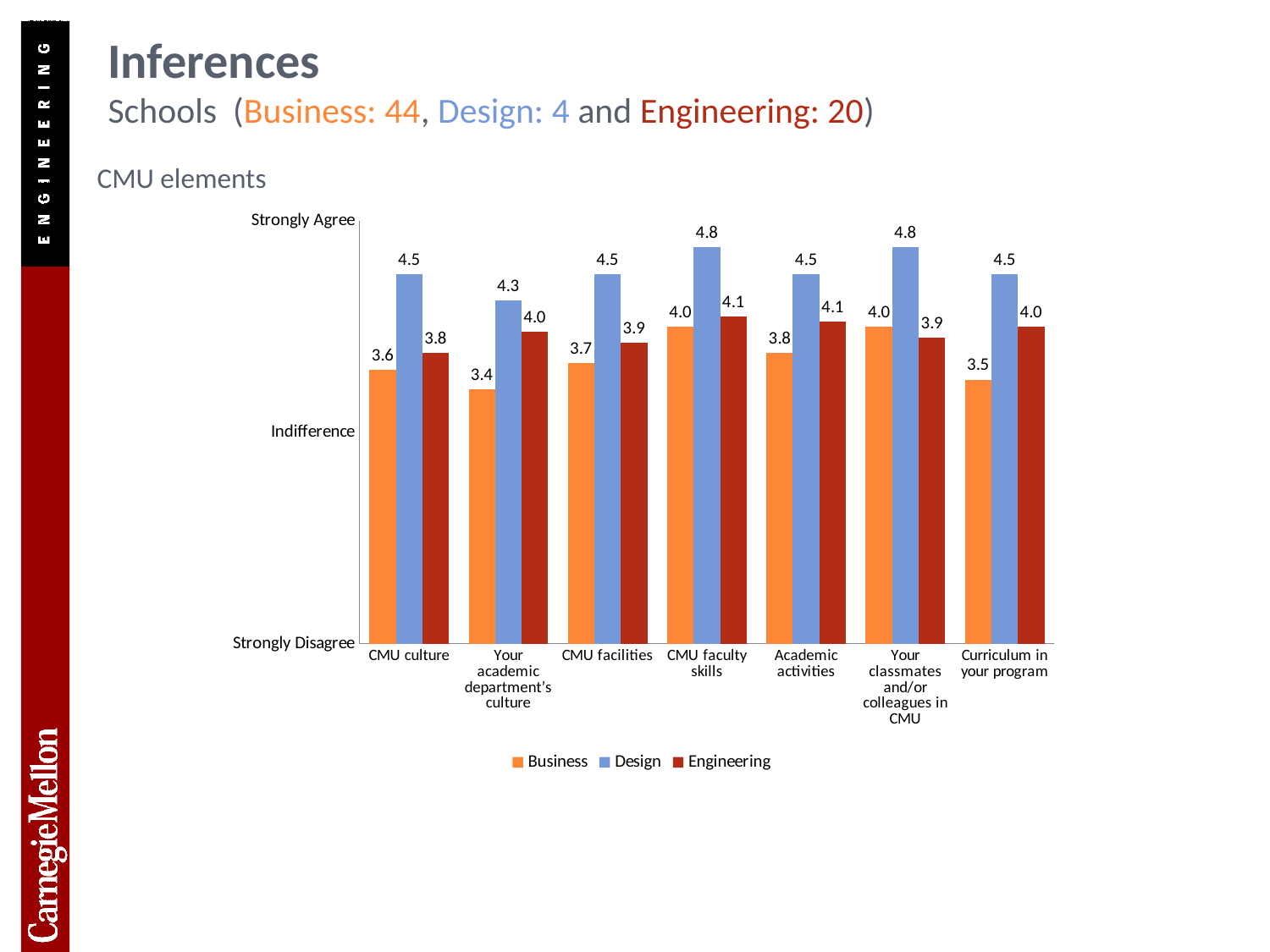
Which category has the lowest Business value? Your academic department's culture Which series is shown in blue? Design What is the Design value for CMU faculty skills? 4.8 What is the label at the top of the y axis? Strongly Agree How many categories are shown on the x axis? 7 What is the Business value for Your academic department's culture? 3.4 What kind of chart is shown on the slide? Bar chart What is the Engineering value for Academic activities? 4.1 How many series does the legend list? 3 What is the Business value for CMU culture? 3.6 Which is larger for Curriculum in your program: the Business value or the Engineering value? Engineering What is the difference between the Design and Business values for CMU facilities? 0.8